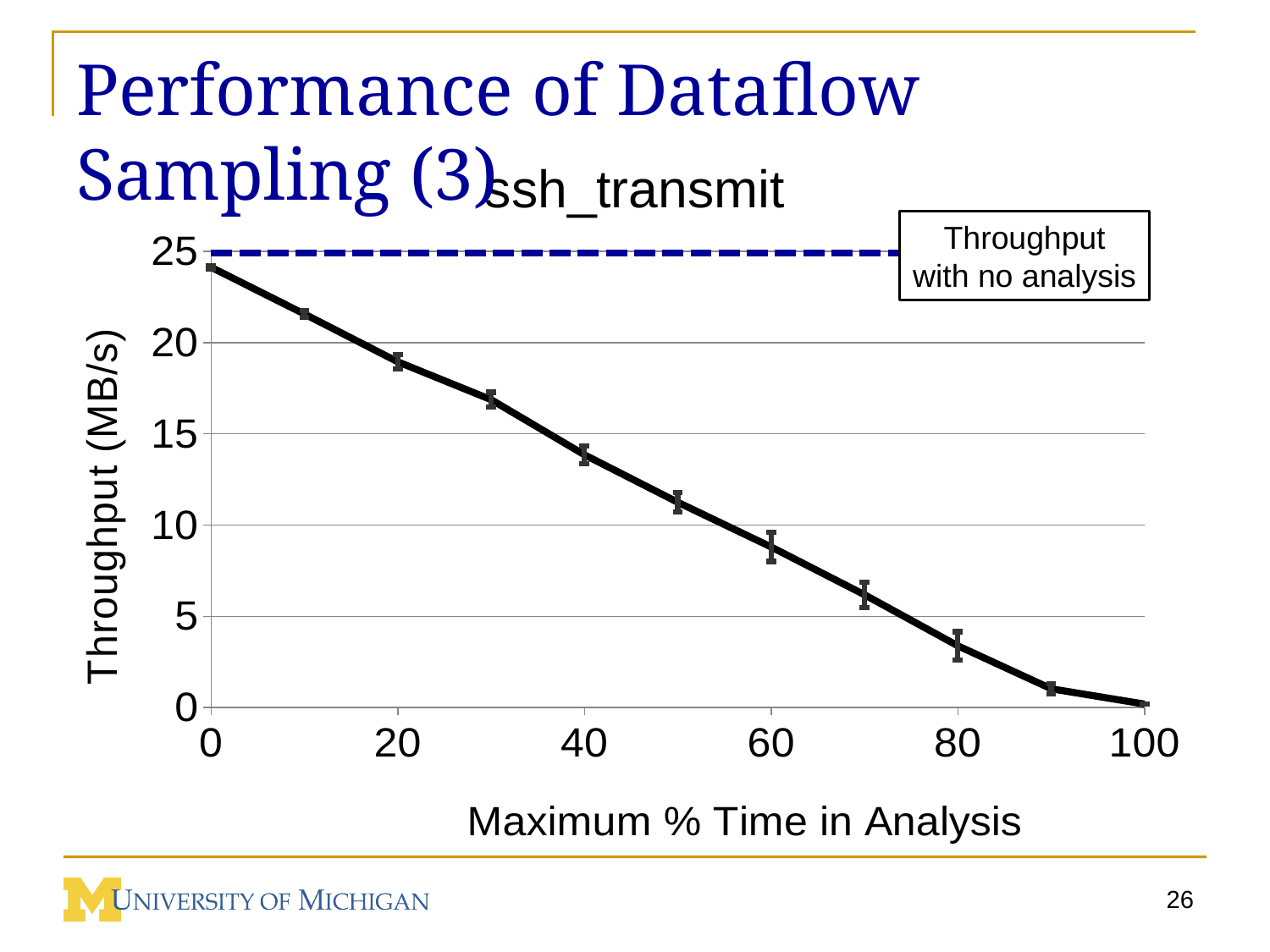
Is the throughput at 30% Maximum Time in Analysis greater or less than 15 MB/s? greater Which has higher throughput: 20% or 60% Maximum Time in Analysis? 20 Is the throughput at 80% Maximum Time in Analysis greater or less than 5 MB/s? less At which Maximum % Time in Analysis value is throughput highest? 0 What is the title of the chart? ssh_transmit At which Maximum % Time in Analysis value is throughput lowest? 100 How many data points are plotted on the solid line? 11 Does throughput rise or fall as Maximum % Time in Analysis increases? fall Is the throughput at 40% Maximum Time in Analysis greater or less than 15 MB/s? less What does the dashed horizontal line at the top of the chart represent? Throughput with no analysis What kind of chart is shown on the slide? line chart